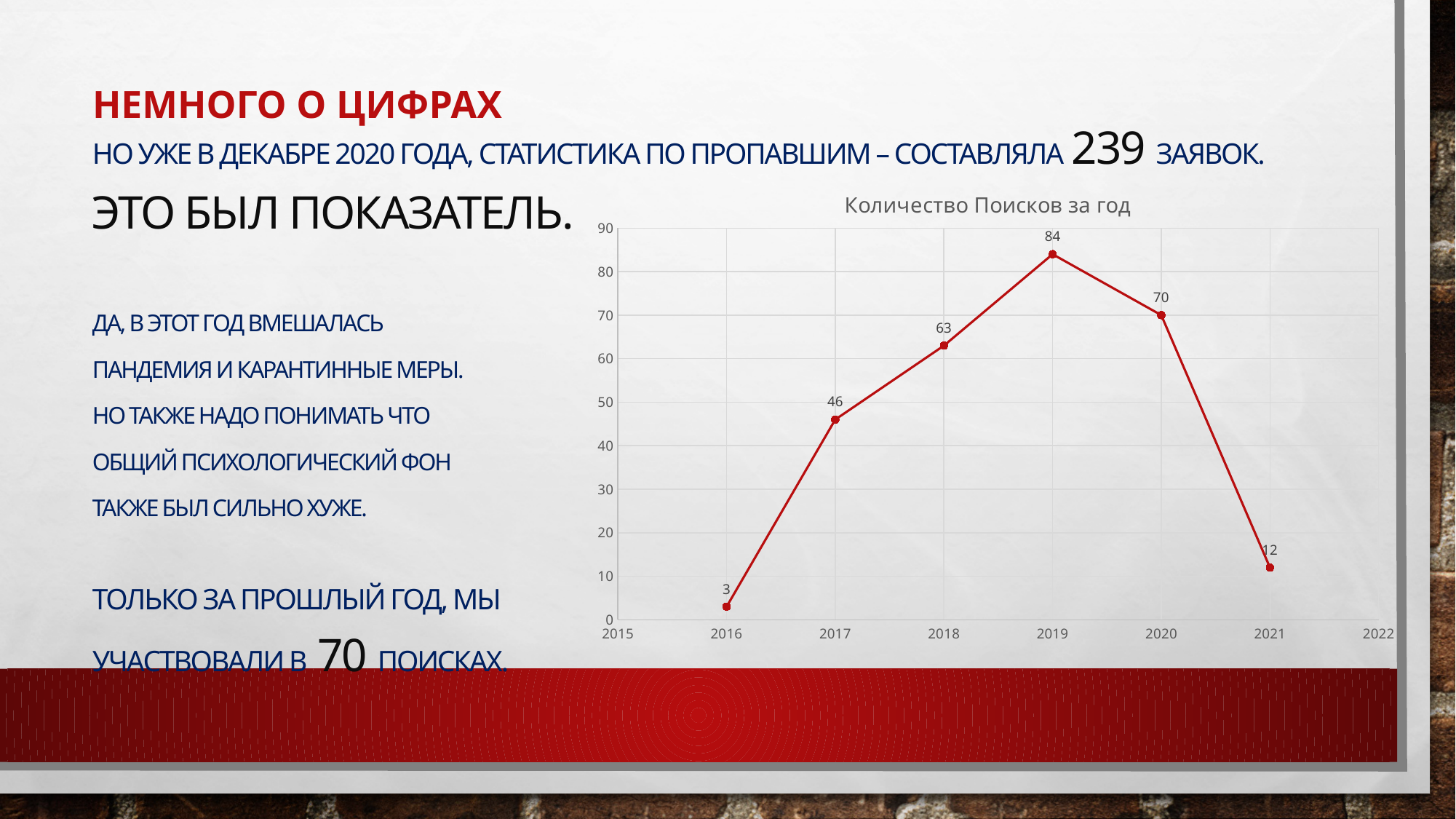
What kind of chart is shown on the slide? line chart How many data points are plotted in the chart? 6 What is the value for 2016 in the chart? 3 Which year has the highest value in the chart? 2019 Which year has the lowest value in the chart? 2016 Which is larger, the value for 2018 or the value for 2020? 2020 What is the difference between the values for 2018 and 2017? 17 What is the value for 2021 in the chart? 12 Is the value for 2017 greater or less than 40? greater What is the title of the chart? Количество Поисков за год What is the difference between the values for 2019 and 2020? 14 What is the value for 2019 in the chart? 84